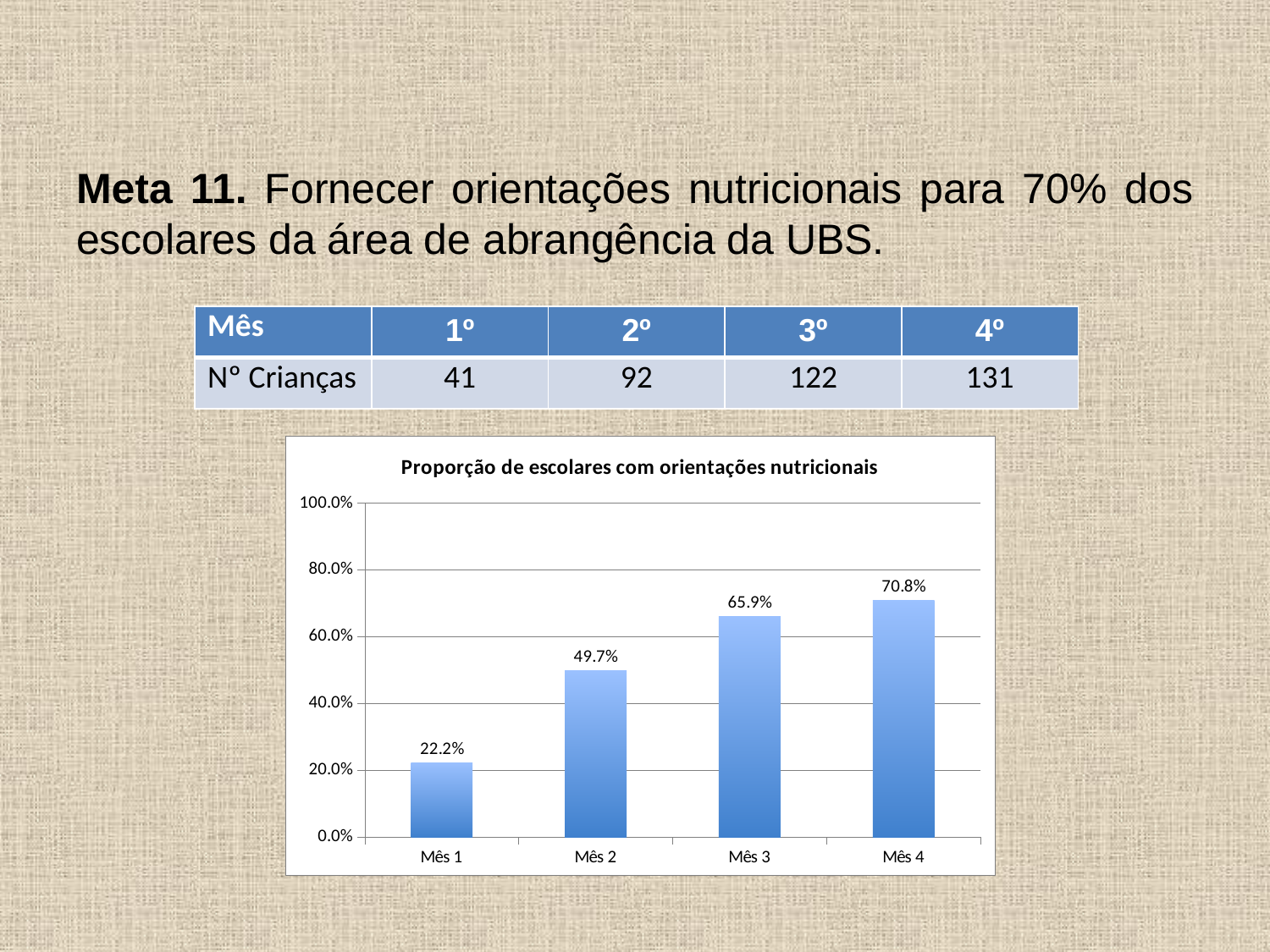
Which month has the highest proportion in the chart? Mês 4 What is the value for Mês 1 in the chart? 22.2% Which month has the lowest proportion in the chart? Mês 1 What is the difference between the values for Mês 4 and Mês 1? 48.6% Which is larger, the value for Mês 2 or the value for Mês 3? Mês 3 How many months are shown on the x axis of the chart? 4 Do the values rise or fall from Mês 1 to Mês 4? rise Is the value for Mês 2 greater or less than 60.0%? less What is the value for Mês 4 in the chart? 70.8% What kind of chart is shown on the slide? bar chart What is the value for Mês 2 in the chart? 49.7% What is the value for Mês 3 in the chart? 65.9%